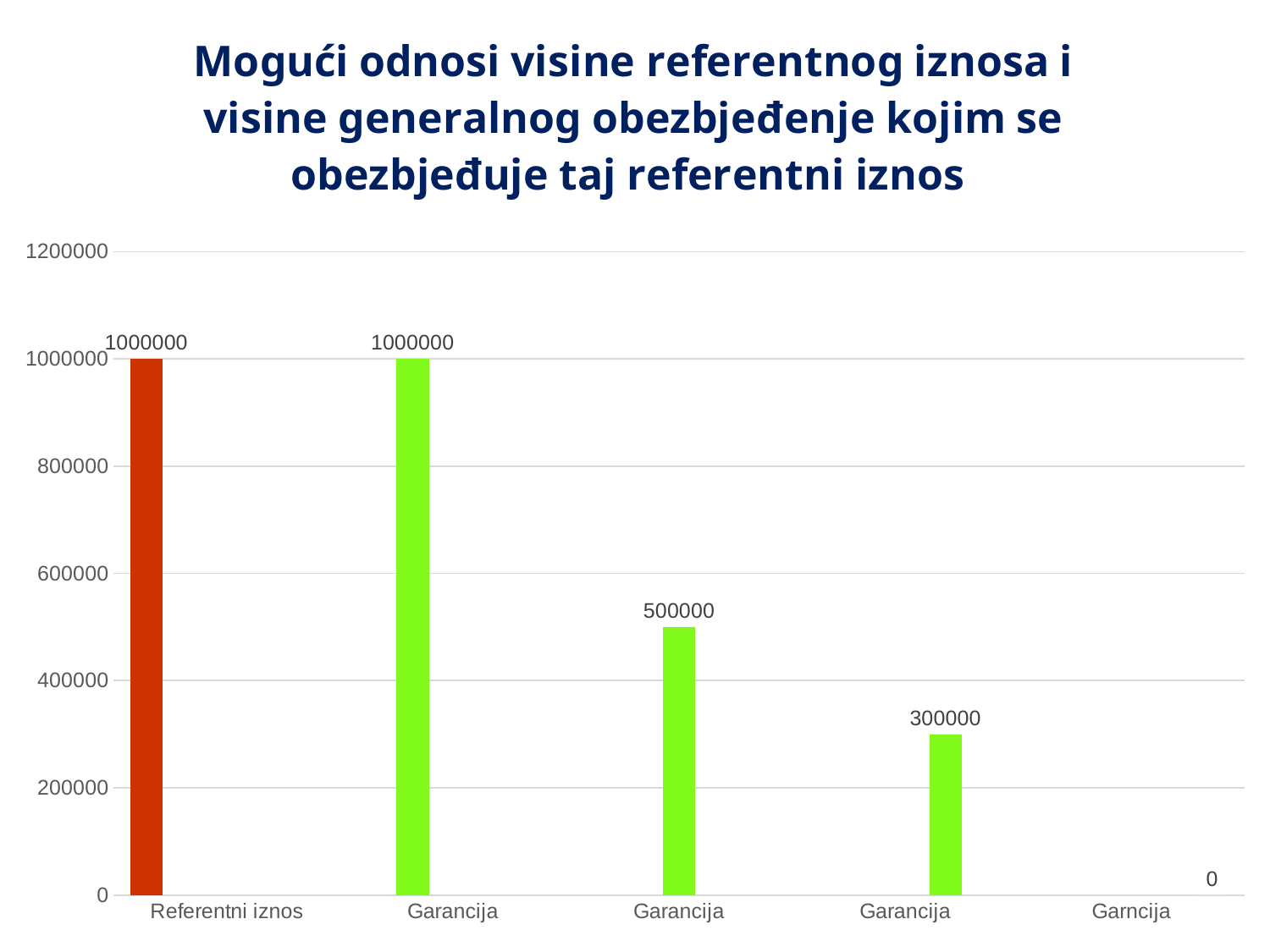
What colour is the Referentni iznos bar? red What is the difference between Referentni iznos and the fourth bar (300000)? 700000 What kind of chart is this? bar chart Do the values rise or fall from left to right across the Garancija bars? fall Which category has the lowest value? Garncija Which is larger, the third bar from the left or the fourth bar from the left? the third bar (500000) What is the value of the fourth bar from the left (the third Garancija bar)? 300000 How many categories are shown on the x axis? 5 What is the difference between the second bar (1000000) and the third bar (500000)? 500000 What is the value for Referentni iznos? 1000000 What is the value of the third bar from the left (the second Garancija bar)? 500000 What is the value for Garncija, the rightmost category? 0